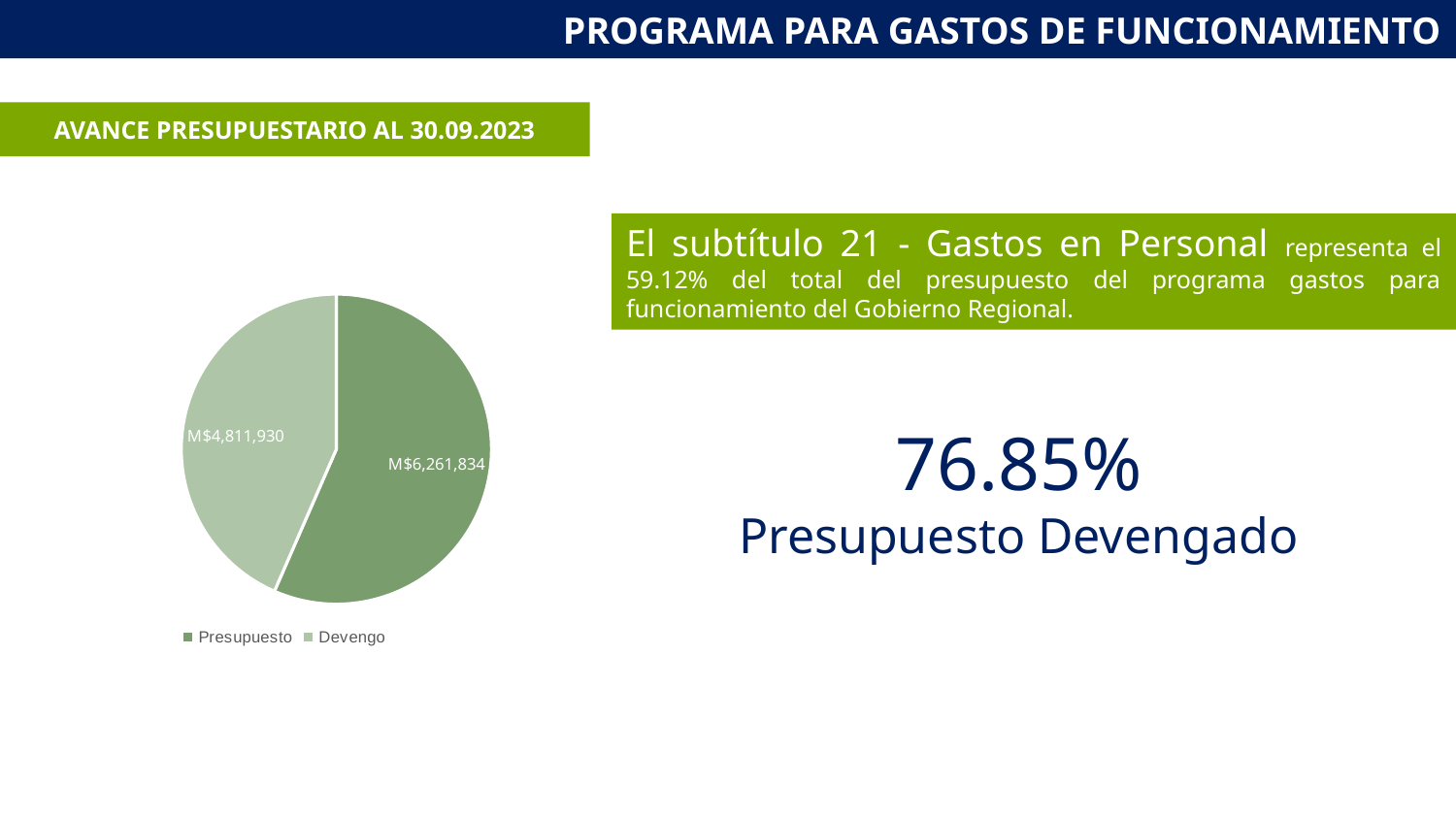
Which slice of the pie chart is the largest? Presupuesto What is the value shown for Presupuesto in the pie chart? M$6,261,834 Which slice of the pie chart is the smallest? Devengo How many entries does the pie chart's legend list? 2 What is the value shown for Devengo in the pie chart? M$4,811,930 What are the two legend entries of the pie chart? Presupuesto and Devengo What share of the pie chart does the Devengo slice represent? 43.45% How many slices does the pie chart have? 2 What is the difference between the Presupuesto value and the Devengo value in the pie chart? M$1,449,904 Which is larger in the pie chart, Presupuesto or Devengo? Presupuesto What kind of chart is shown on the slide? Pie chart Which slice of the pie chart is shown in the darker green colour? Presupuesto